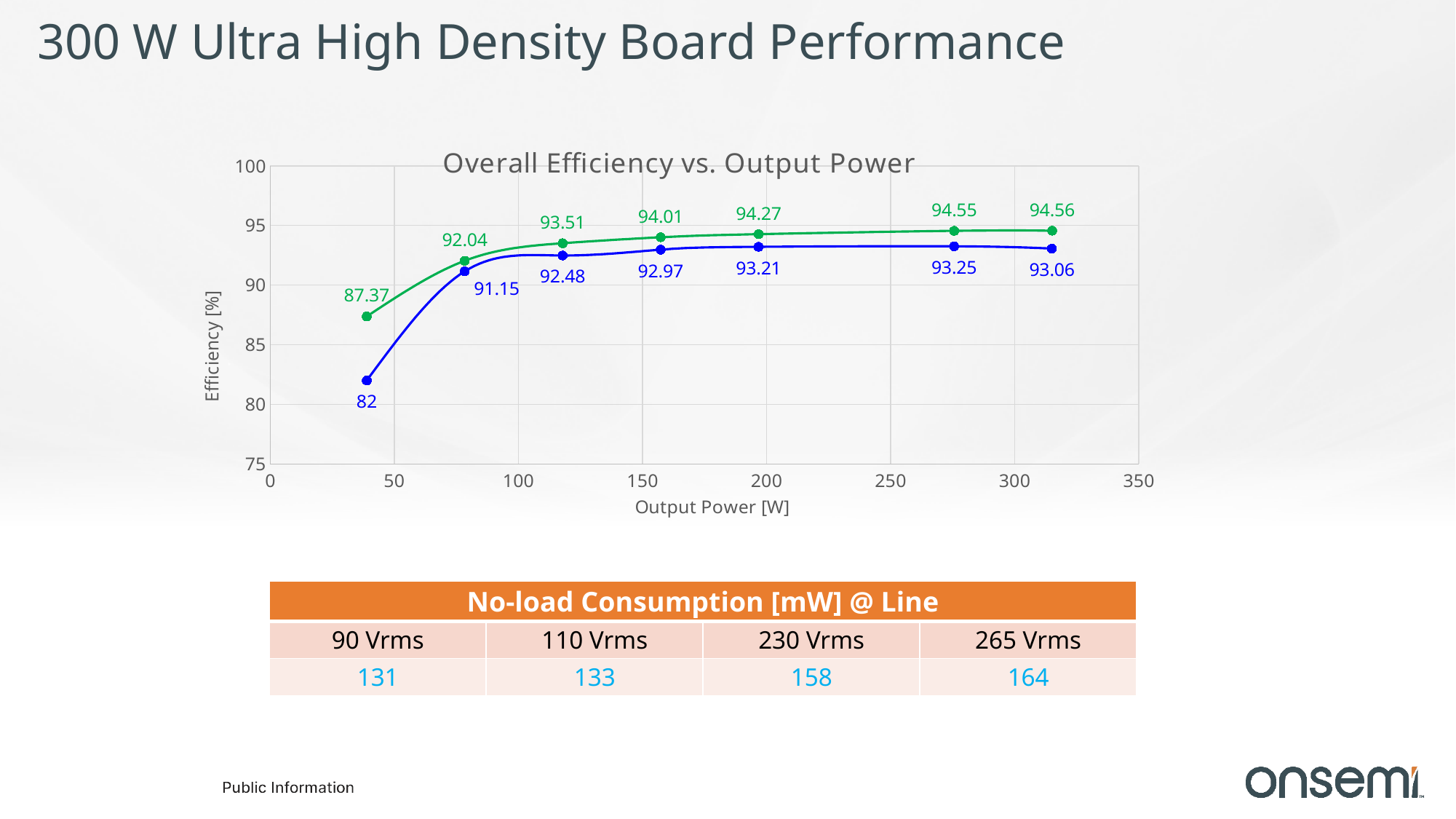
What is the title of the chart? Overall Efficiency vs. Output Power What is the highest labelled value on the blue line? 93.25 What kind of chart is shown on the slide? line chart At the leftmost output power point, which line has the higher efficiency, the green line or the blue line? green line What is the labelled value of the first (leftmost) point on the green line? 87.37 What is the lowest labelled value on the blue line? 82 What is the highest labelled value on the green line? 94.56 What is the label of the vertical axis of the chart? Efficiency [%] What is the difference between the last point on the green line (94.56) and the last point on the blue line (93.06)? 1.50 Is the value of the first (leftmost) point on the blue line greater or less than 85? less How many data points are plotted on the green line? 7 How many lines are plotted on the chart? 2